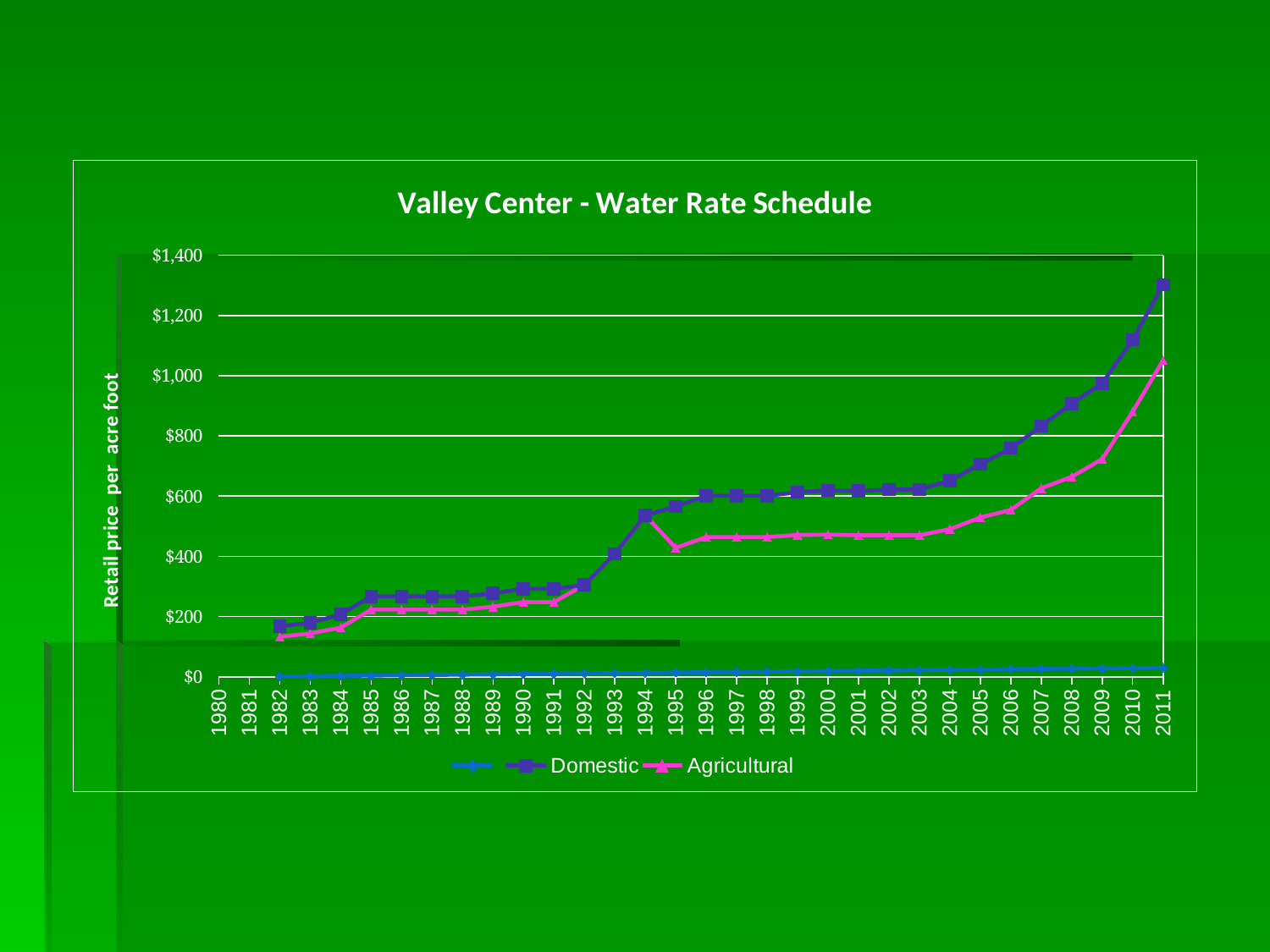
In 2011, which series has the higher value, Domestic or Agricultural? Domestic What is the label on the vertical axis? Retail price per acre foot What kind of chart is shown on the slide? line chart Is the Agricultural value for 2000 greater or less than $600? less What is the title of the chart? Valley Center - Water Rate Schedule Is the Domestic value for 2008 greater or less than $800? greater Is the Domestic value for 1982 greater or less than $200? less How many year labels are shown on the x axis? 32 How many named series does the legend list? 2 Do the Domestic values generally rise or fall from 1982 to 2011? rise